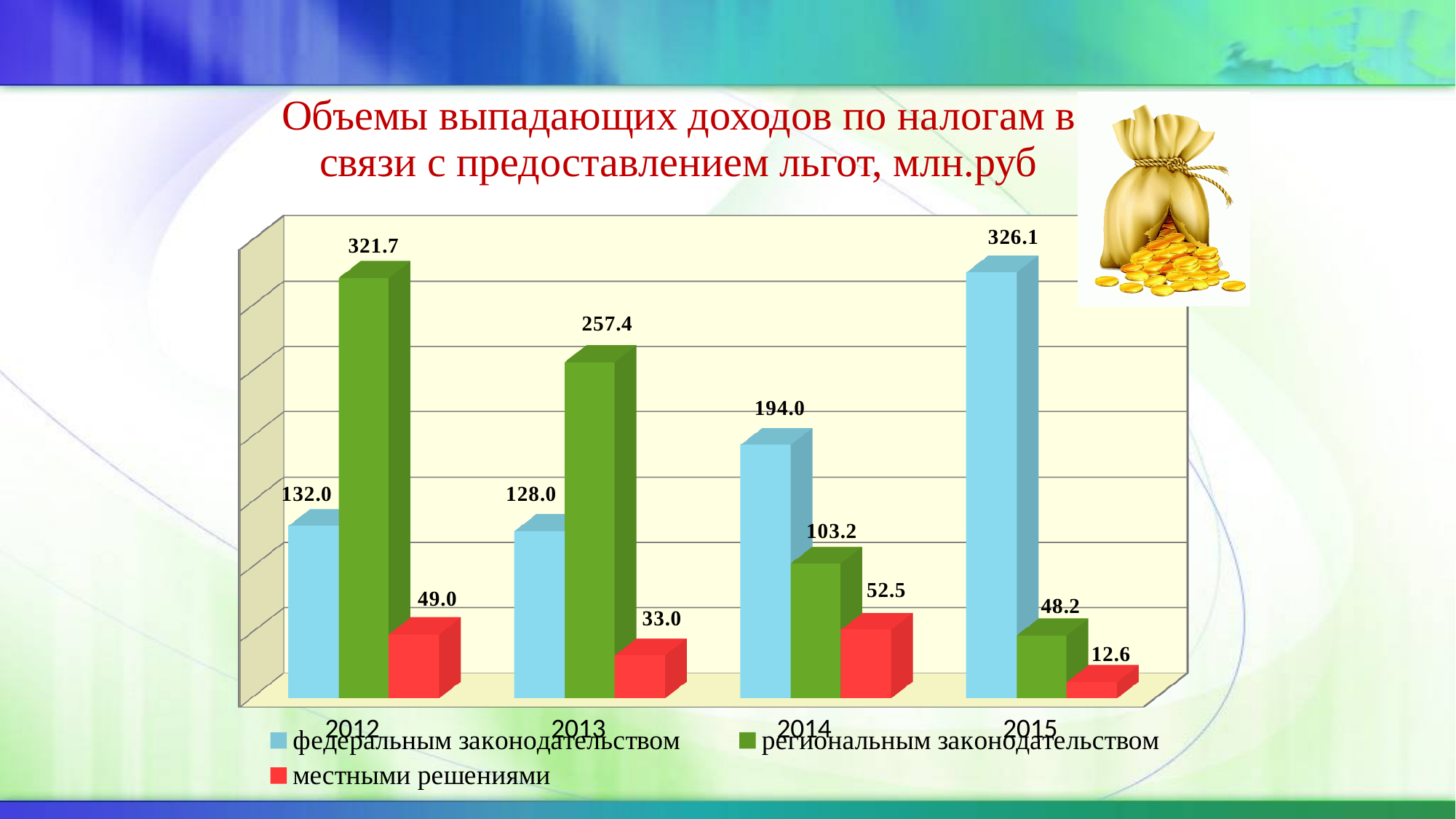
Which colour represents местными решениями in the legend? red What is the value for федеральным законодательством in 2015? 326.1 What kind of chart is shown on the slide? bar chart Which is larger in 2014: федеральным законодательством or региональным законодательством? федеральным законодательством In which year is the value for региональным законодательством the highest? 2012 How many years are shown on the x axis? 4 What is the value for региональным законодательством in 2013? 257.4 In which year is the value for местными решениями the lowest? 2015 What is the value for местными решениями in 2014? 52.5 Does the value for региональным законодательством rise or fall from 2012 to 2015? fall How many series does the legend list? 3 What is the difference between the федеральным законодательством values for 2015 and 2014? 132.1